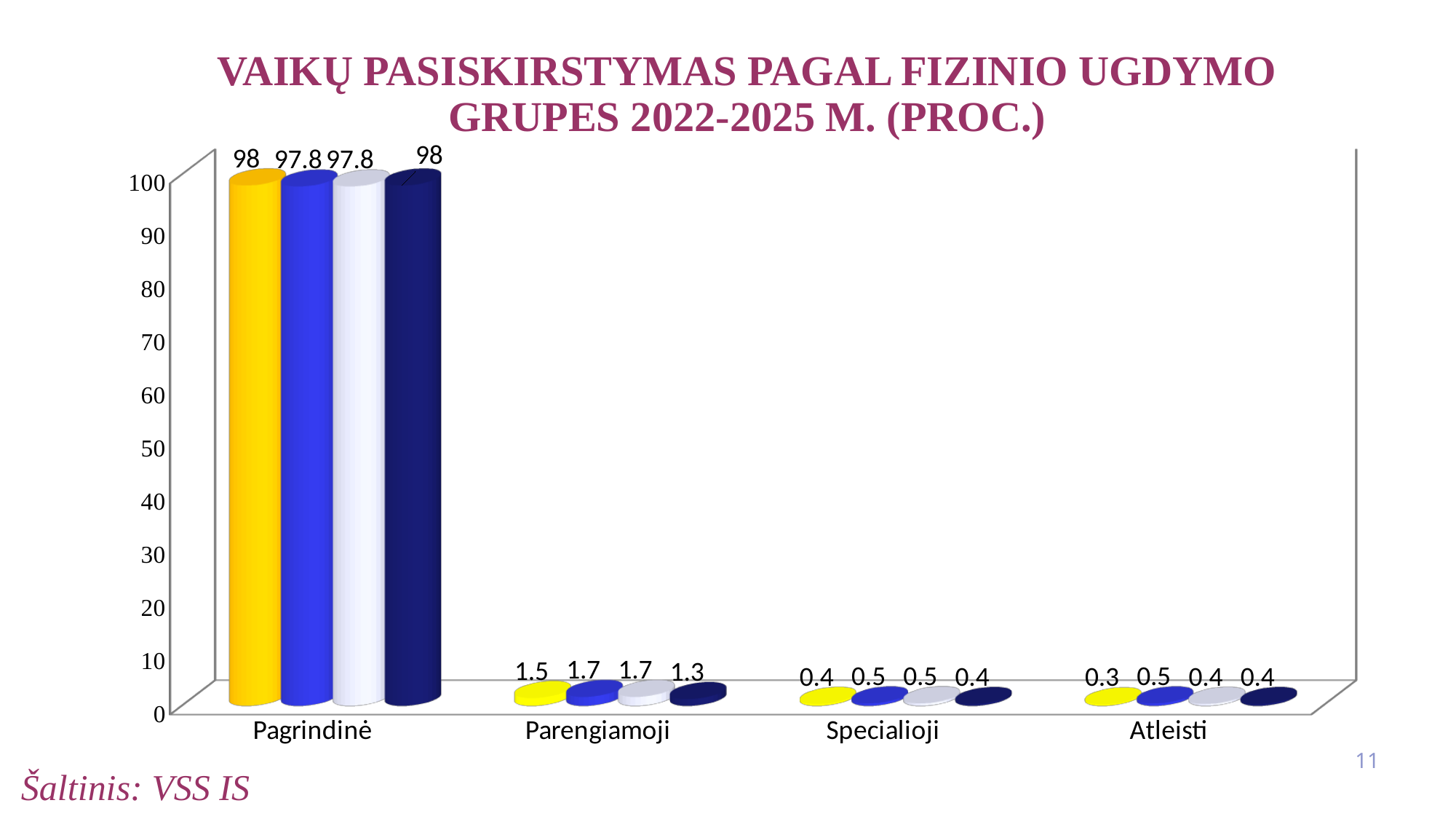
What is the value of the bright blue (second) bar for Specialioji? 0.5 How many categories are shown on the x axis? 4 What kind of chart is shown on the slide? bar chart What is the value of the yellow (first) bar for Pagrindinė? 98 Which category has the lowest value for the yellow (first) bar? Atleisti Which is larger: the bright blue (second) bar for Parengiamoji or the bright blue (second) bar for Specialioji? Parengiamoji What is the value of the yellow (first) bar for Atleisti? 0.3 Is the value of the white (third) bar for Pagrindinė greater or less than 90? greater Which category has the highest values? Pagrindinė What is the value of the dark navy (fourth) bar for Parengiamoji? 1.3 What is the title of the chart? VAIKŲ PASISKIRSTYMAS PAGAL FIZINIO UGDYMO GRUPES 2022-2025 M. (PROC.) What is the difference between the yellow (first) bar for Pagrindinė and the yellow (first) bar for Parengiamoji? 96.5